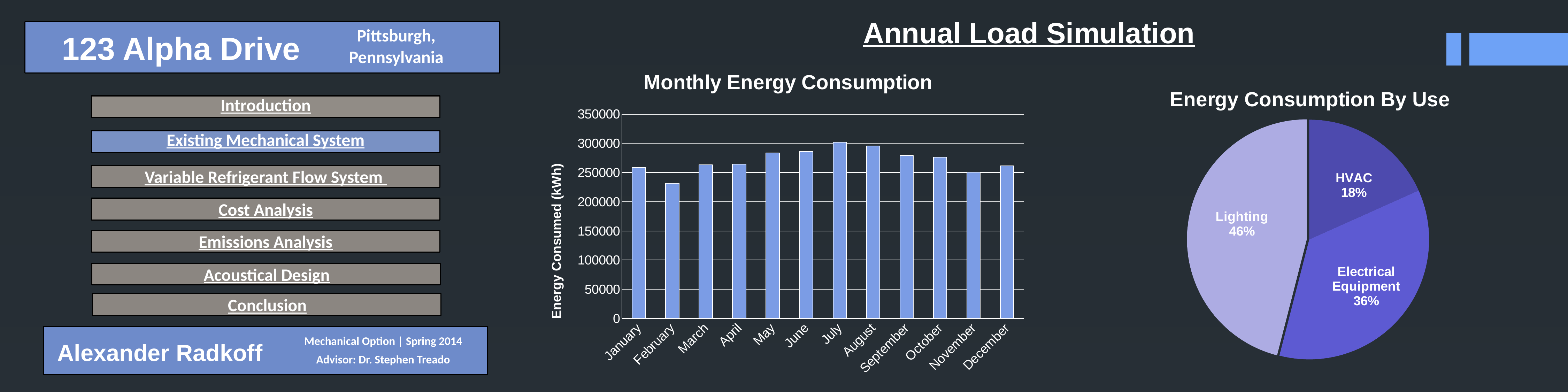
In the Energy Consumption By Use pie chart, what share does Lighting have? 46% In the Monthly Energy Consumption chart, which month has the lowest energy consumption? February In the Energy Consumption By Use pie chart, which category has the smallest share? HVAC In the Monthly Energy Consumption chart, which month has the highest energy consumption? July What kind of chart is the Monthly Energy Consumption chart? bar chart In the Monthly Energy Consumption chart, do the values rise or fall from February to July? rise In the Monthly Energy Consumption chart, is the value for February greater or less than 250000? less In the Monthly Energy Consumption chart, is the value for May greater or less than 250000? greater In the Monthly Energy Consumption chart, is the value for November greater or less than 300000? less In the Monthly Energy Consumption chart, what is the label of the vertical axis? Energy Consumed (kWh) In the Energy Consumption By Use pie chart, what is the difference between the Lighting share and the Electrical Equipment share? 10% In the Monthly Energy Consumption chart, how many months are plotted? 12